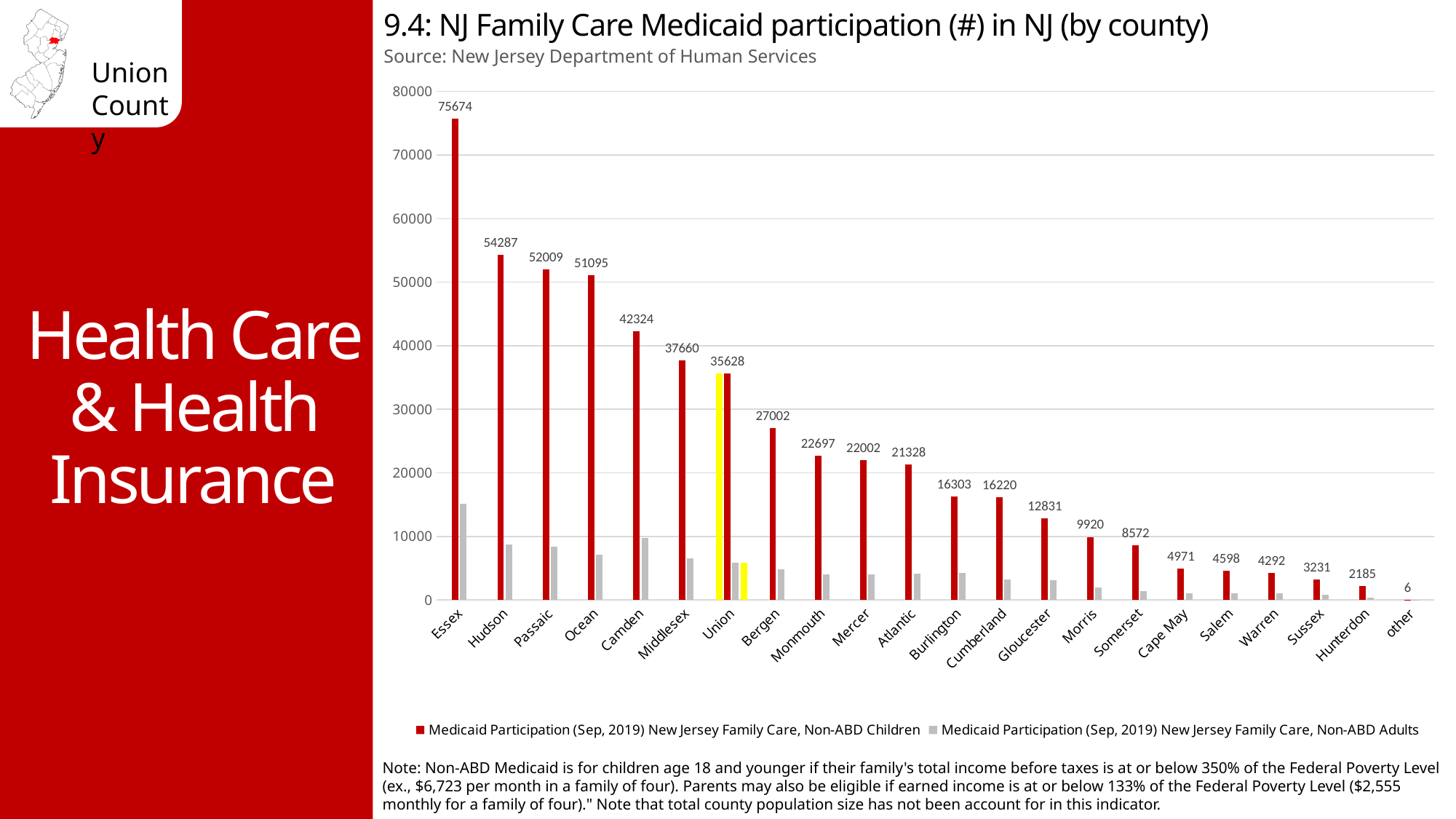
How many categories are shown on the x axis? 22 Which category has the lowest Non-ABD Children Medicaid participation? other Which county's bars are highlighted in yellow? Union Which has a larger Non-ABD Children value, Camden or Middlesex? Camden What is the Non-ABD Children Medicaid participation value for Union? 35628 What is the difference between the Non-ABD Children values for Hudson and Passaic? 2278 What is the Non-ABD Children Medicaid participation value for Essex? 75674 What kind of chart is shown on the slide? Bar chart Which county has the highest Non-ABD Children Medicaid participation? Essex Is the Non-ABD Adults value for Essex greater or less than 10000? greater How many series does the legend list? 2 What is the Non-ABD Children Medicaid participation value for Cape May? 4971